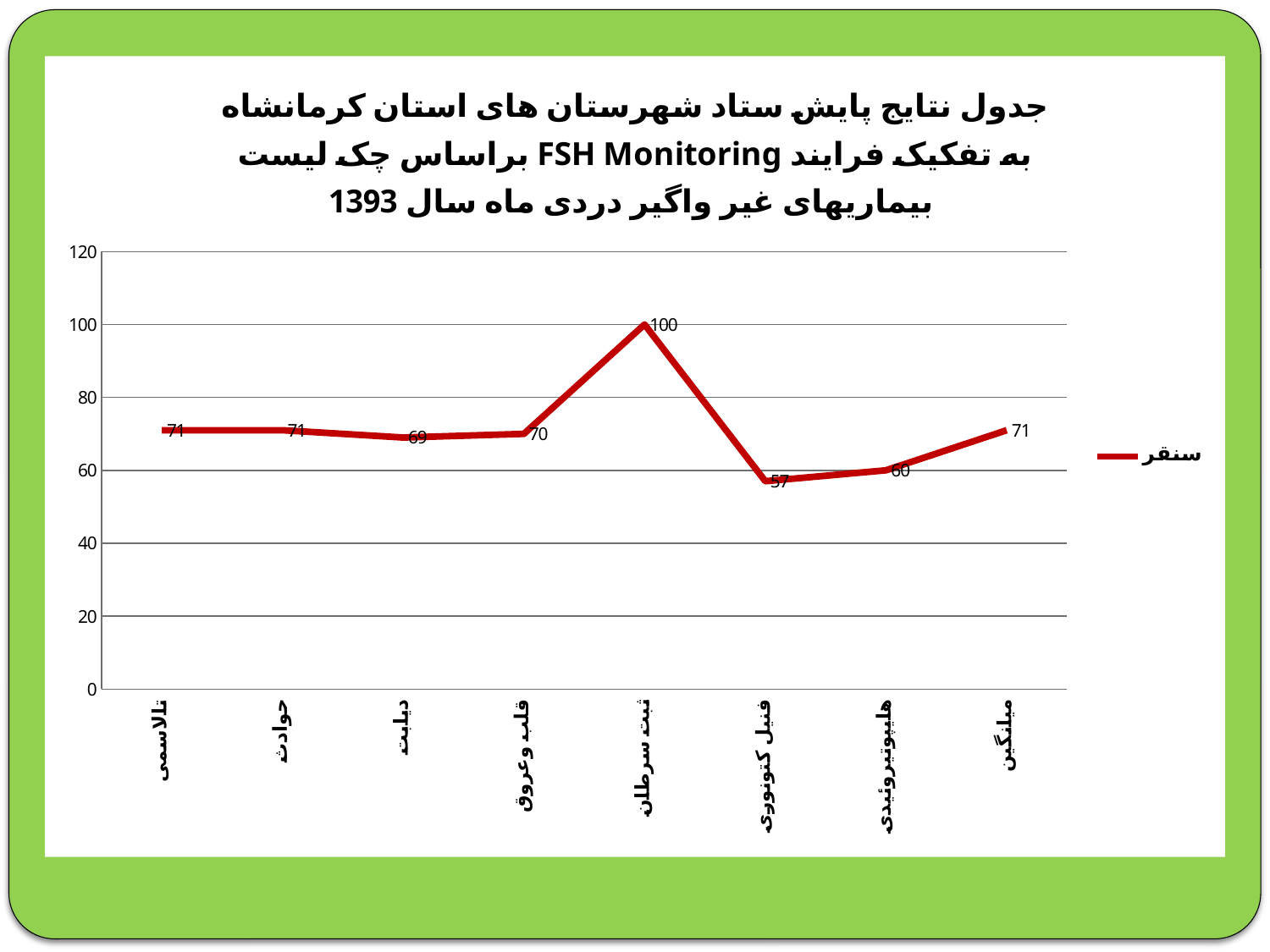
Which category has the lowest value? فنیل کتونوری What is the value for دیابت? 69 What is the value for میانگین? 71 Which category has the highest value? ثبت سرطان What is the name of the series shown in the legend? سنقر What is the value for فنیل کتونوری? 57 How many categories are plotted on the x axis? 8 What is the difference between the values for ثبت سرطان and فنیل کتونوری? 43 How many series does the legend list? 1 What is the value for ثبت سرطان? 100 Which is larger, the value for هیپوتیروئیدی or the value for قلب و عروق? قلب و عروق What type of chart is shown on the slide? line chart